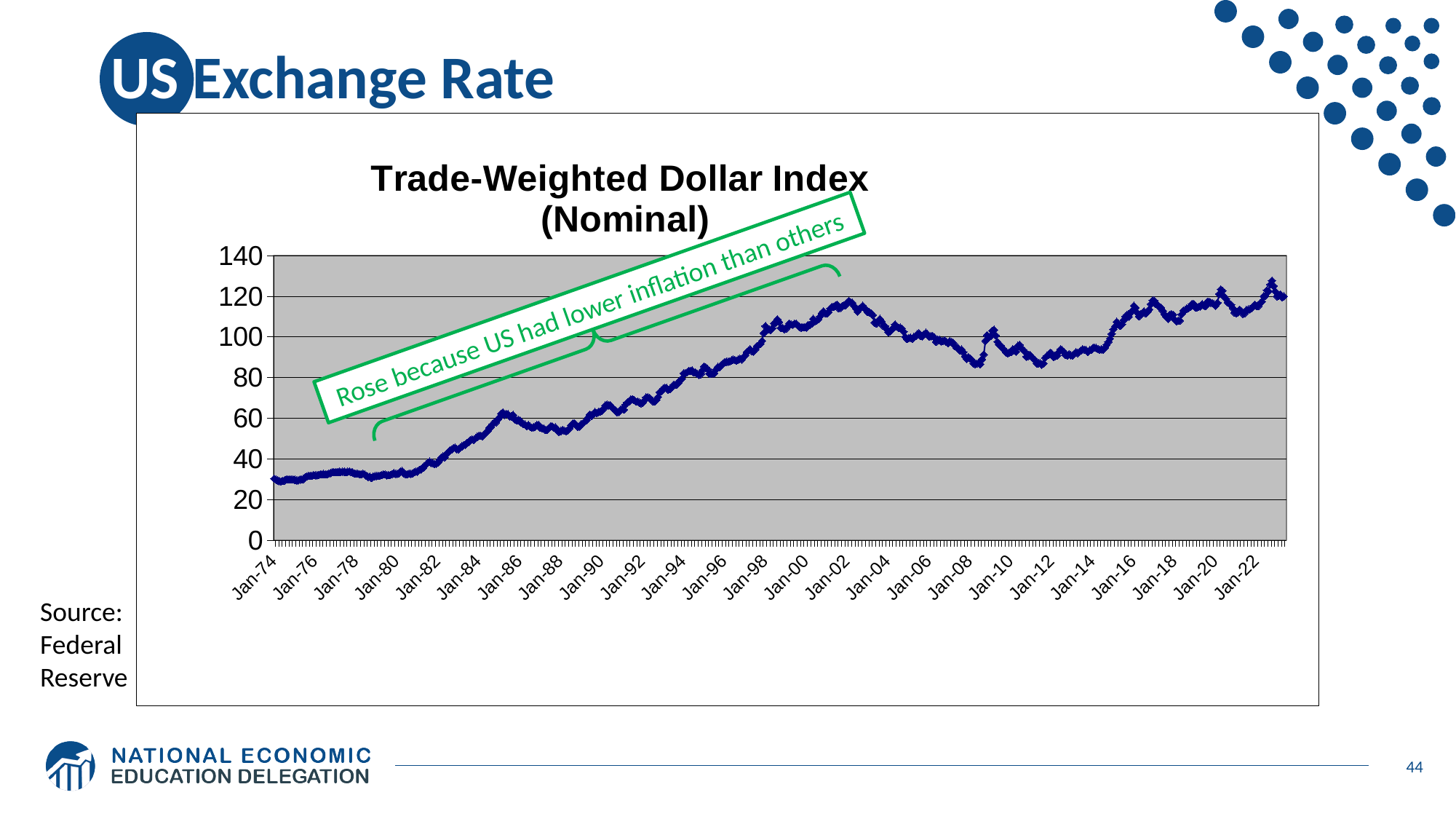
Is the value of the index at Jan-74 greater or less than 40? less Is the value of the index at Jan-12 greater or less than 100? less Does the index rise or fall between Jan-74 and Jan-86? rise Which is larger, the index value at Jan-02 or at Jan-12? Jan-02 How many data series are plotted on the chart? 1 Is the value of the index at Jan-02 greater or less than 100? greater What is the title of the chart? Trade-Weighted Dollar Index (Nominal) Does the index rise or fall between Jan-02 and Jan-08? fall What kind of chart is shown on the slide? line chart What does the green annotation on the chart say? Rose because US had lower inflation than others